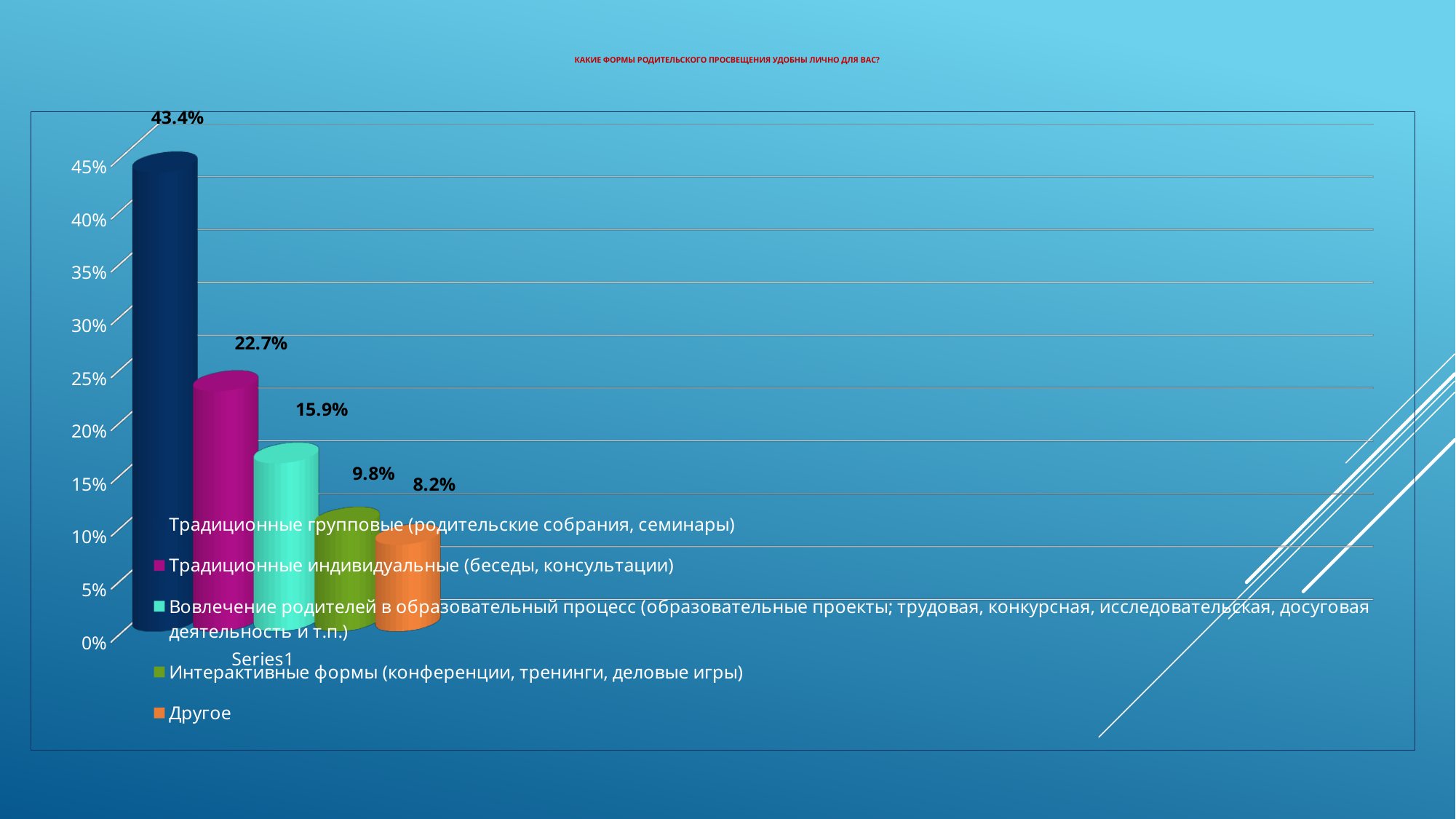
What is the value for "Другое"? 8.2% What is the value for "Традиционные индивидуальные (беседы, консультации)"? 22.7% Which category has the lowest value? Другое How many entries does the legend list? 5 Which is larger: the value for "Вовлечение родителей в образовательный процесс" or the value for "Интерактивные формы"? Вовлечение родителей в образовательный процесс What is the value for "Интерактивные формы (конференции, тренинги, деловые игры)"? 9.8% Which category has the highest value? Традиционные групповые (родительские собрания, семинары) What colour is the bar for "Другое"? Orange What is the value for "Традиционные групповые (родительские собрания, семинары)"? 43.4% How many bars are plotted in the chart? 5 What is the difference between the values for "Традиционные групповые" and "Традиционные индивидуальные"? 20.7% What type of chart is shown on the slide? Bar chart